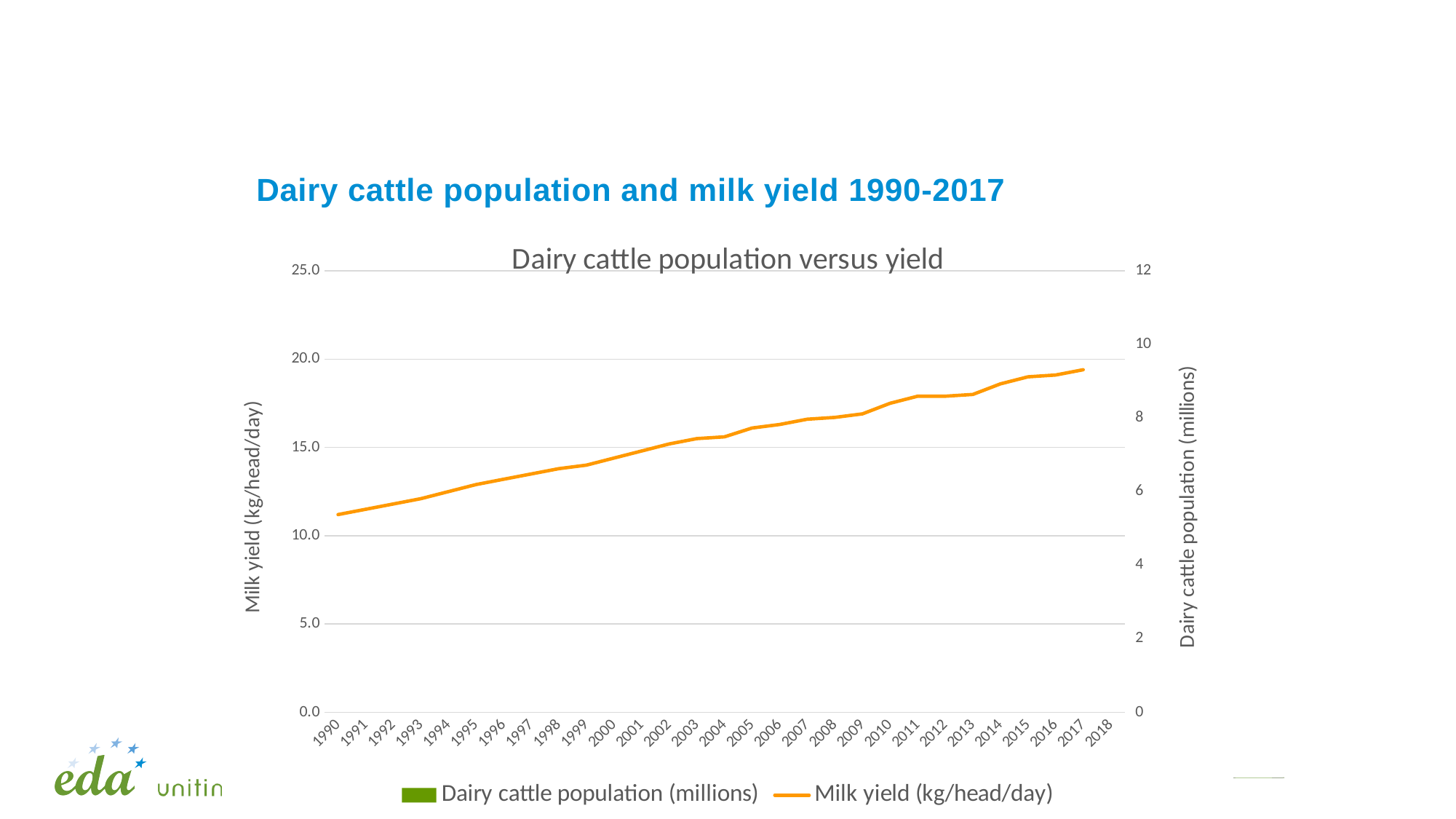
Is the milk yield for 2017 greater or less than 20.0? less In which year is the milk yield lowest? 1990 Is the milk yield for 2005 greater or less than 15.0? greater Is the milk yield for 1990 greater or less than 15.0? less In which year is the milk yield highest? 2017 Which year has the larger milk yield, 2000 or 2010? 2010 Does the milk yield line rise or fall from 1990 to 2017? rise How many series does the legend list? 2 What is the title shown inside the chart area? Dairy cattle population versus yield What kind of chart is shown on the slide? line chart What is the label of the left vertical axis? Milk yield (kg/head/day)